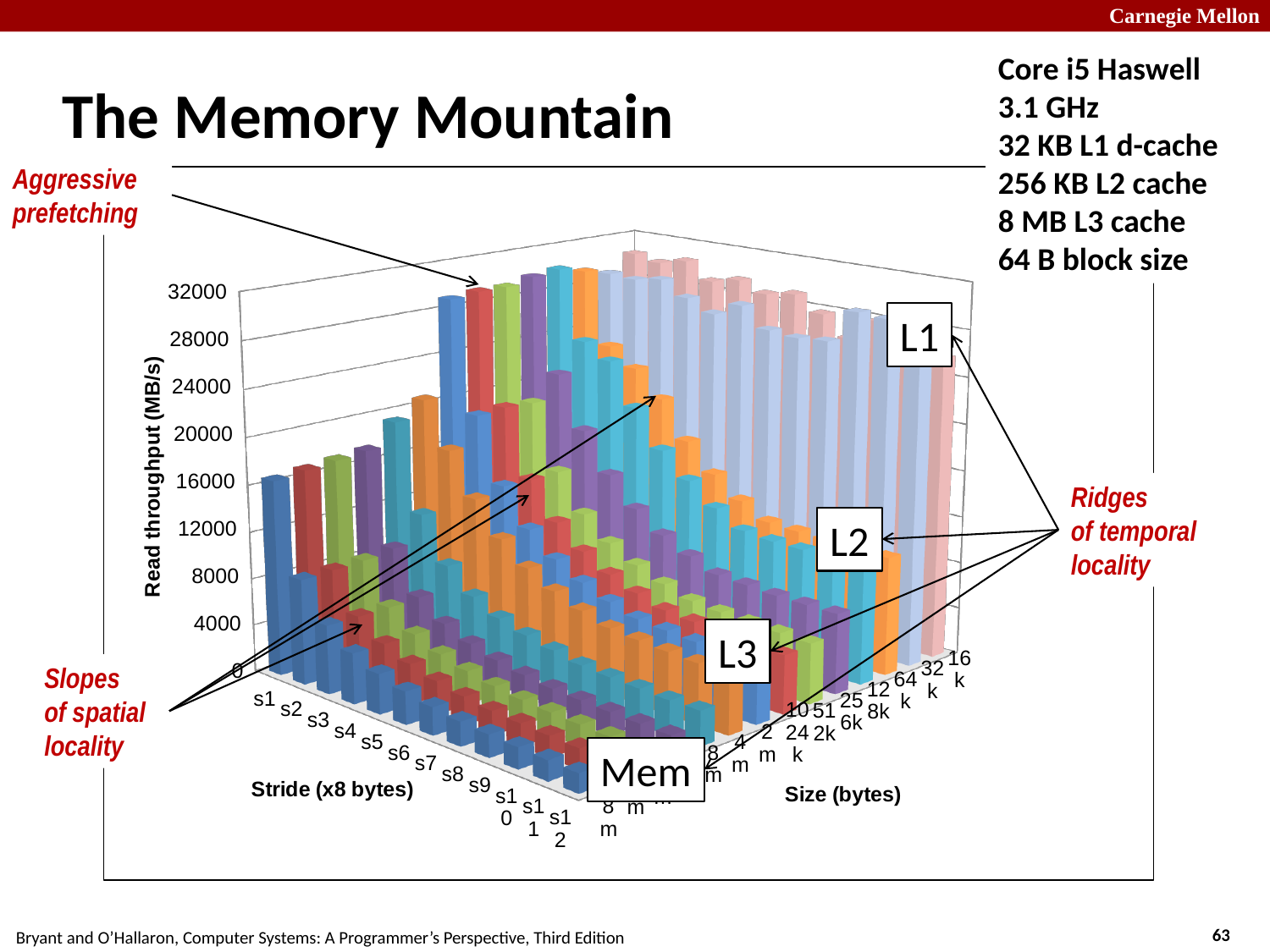
What kind of chart is shown on the slide? 3D bar chart What is the interval between consecutive ticks on the read throughput axis? 4000 What is the label of the vertical axis of the chart? Read throughput (MB/s) What is the highest tick value shown on the read throughput axis? 32000 Is the read throughput for stride s1 at the largest size (front-left bar) greater or less than 8000? greater What is the title of the chart on the slide? The Memory Mountain Which is larger for the largest size: the read throughput at stride s1 or at stride s12? s1 Is the read throughput for stride s1 at the largest size (front-left bar) greater or less than 24000? less Which cache level label is placed at the highest ridge of the chart? L1 For a fixed size, does read throughput rise or fall as the stride increases from s1 to s12? fall Which stride category has the highest read throughput for the largest size (front row of bars)? s1 How many stride categories (s1 through s12) are shown along the stride axis? 12